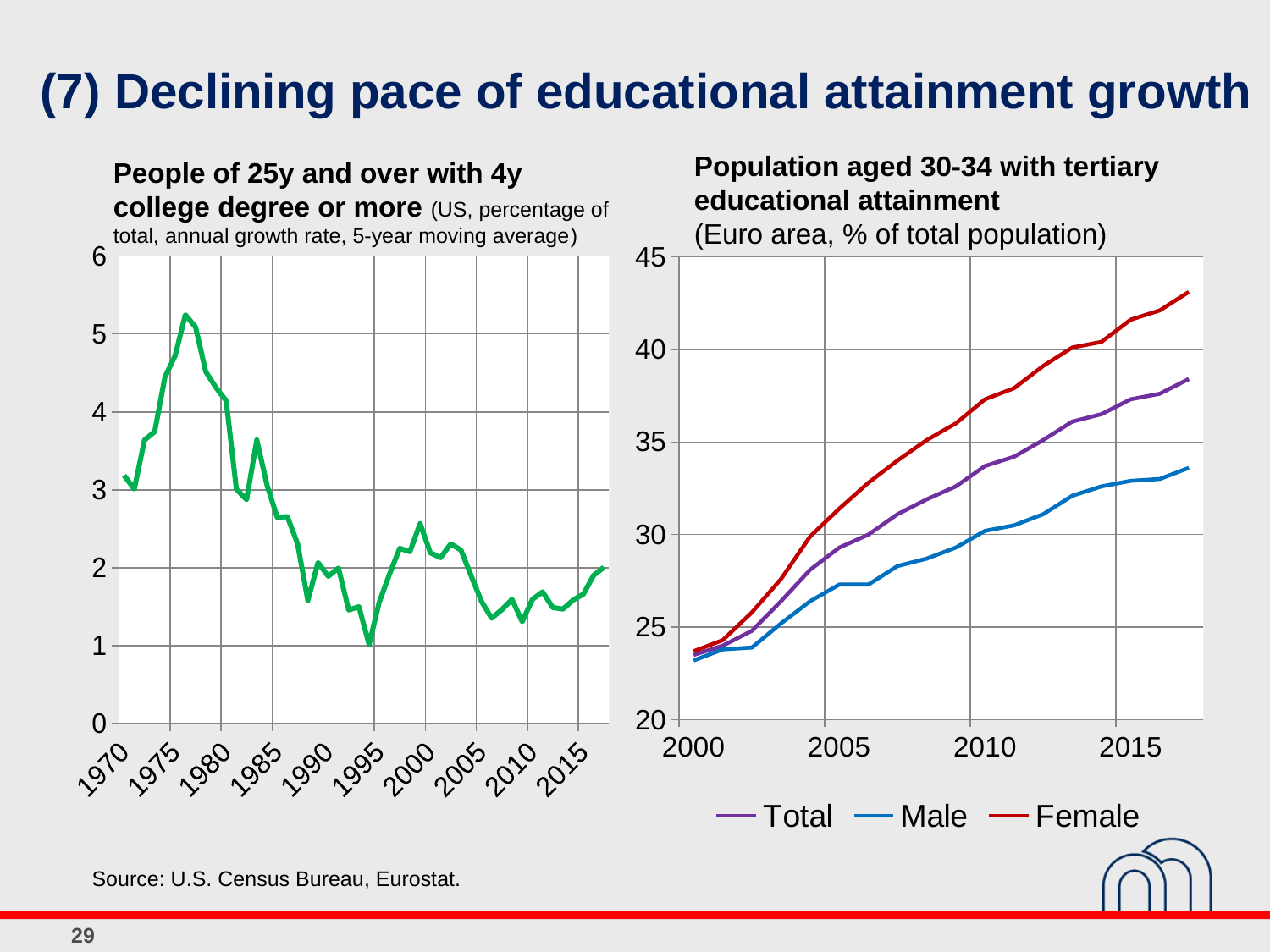
In the right chart, 'Population aged 30-34 with tertiary educational attainment', is the Female value in 2017 greater or less than 40? greater In the right chart, 'Population aged 30-34 with tertiary educational attainment', which series has the lowest values in 2017? Male In the right chart, 'Population aged 30-34 with tertiary educational attainment', is the Male value in 2017 greater or less than 35? less What type of chart is the right chart, 'Population aged 30-34 with tertiary educational attainment'? line chart In the left chart, 'People of 25y and over with 4y college degree or more', is the peak value around 1977 greater or less than 5? greater In the right chart, 'Population aged 30-34 with tertiary educational attainment', which series has the highest values in 2017? Female In the right chart, 'Population aged 30-34 with tertiary educational attainment', which is larger in 2015, the Female value or the Male value? Female How many series does the legend of the right chart, 'Population aged 30-34 with tertiary educational attainment', list? 3 In the right chart, 'Population aged 30-34 with tertiary educational attainment', do the values rise or fall from 2000 to 2017? rise What type of chart is the left chart, 'People of 25y and over with 4y college degree or more'? line chart